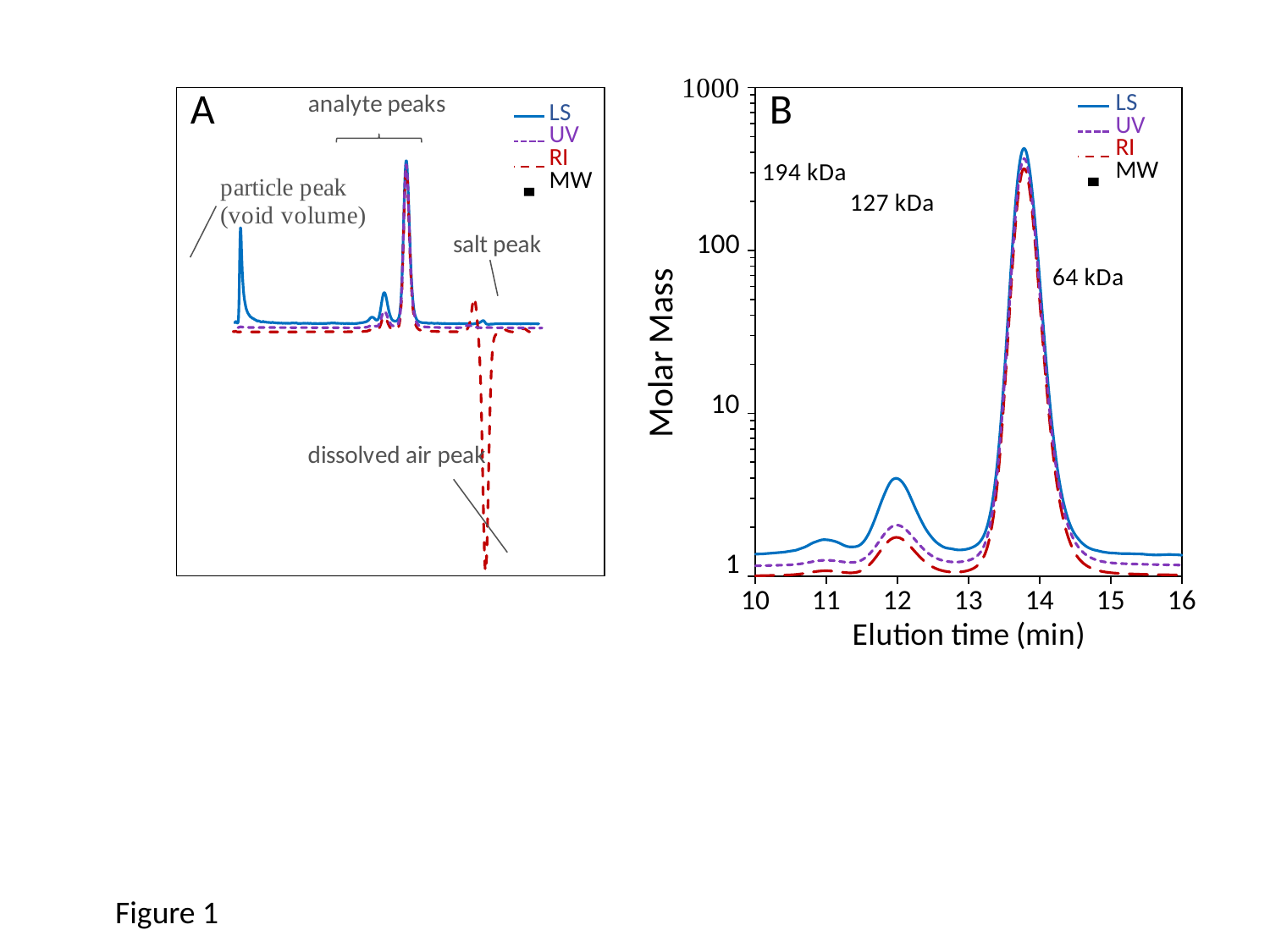
How many series does the legend of chart A list? 4 In chart B, what is the largest molar mass value annotated on the plot? 194 kDa In chart B, which series has the highest value at 12 min? LS What is the y-axis label of chart B? Molar Mass How many series does the legend of chart B list? 4 What is the x-axis label of chart B? Elution time (min) In chart B, is the value of the LS series at 12 min greater or less than 10? less In chart B, is the peak value of the LS series near 14 min greater or less than 100? greater In chart B, which series has the lowest value at 12 min? RI What kind of chart is chart B? line chart In chart B, does the LS series rise or fall between 14 and 16 min? fall In chart B, is the value of the LS series at 16 min greater or less than 10? less